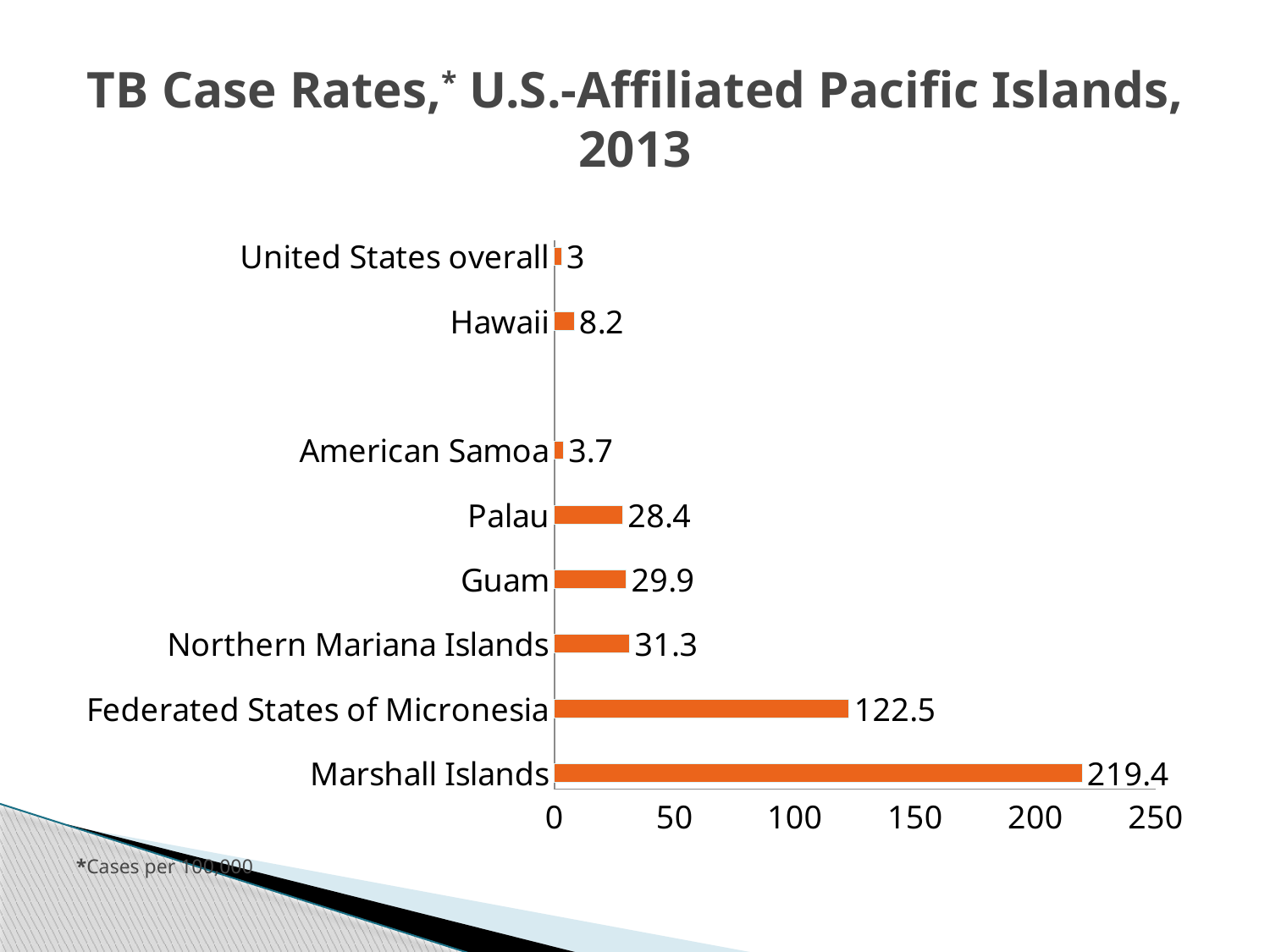
Which has a higher TB case rate, Guam or Palau? Guam What is the title of the chart? TB Case Rates,* U.S.-Affiliated Pacific Islands, 2013 What is the TB case rate for the Federated States of Micronesia? 122.5 Which category has the lowest TB case rate? United States overall What is the TB case rate for American Samoa? 3.7 What is the TB case rate for the Marshall Islands? 219.4 What is the TB case rate for Hawaii? 8.2 How many categories are shown in the chart? 8 What is the difference between the TB case rates of the Marshall Islands and the Federated States of Micronesia? 96.9 Which category has the highest TB case rate? Marshall Islands What kind of chart is shown on the slide? Bar chart Is the value for the Northern Mariana Islands greater or less than 50? less